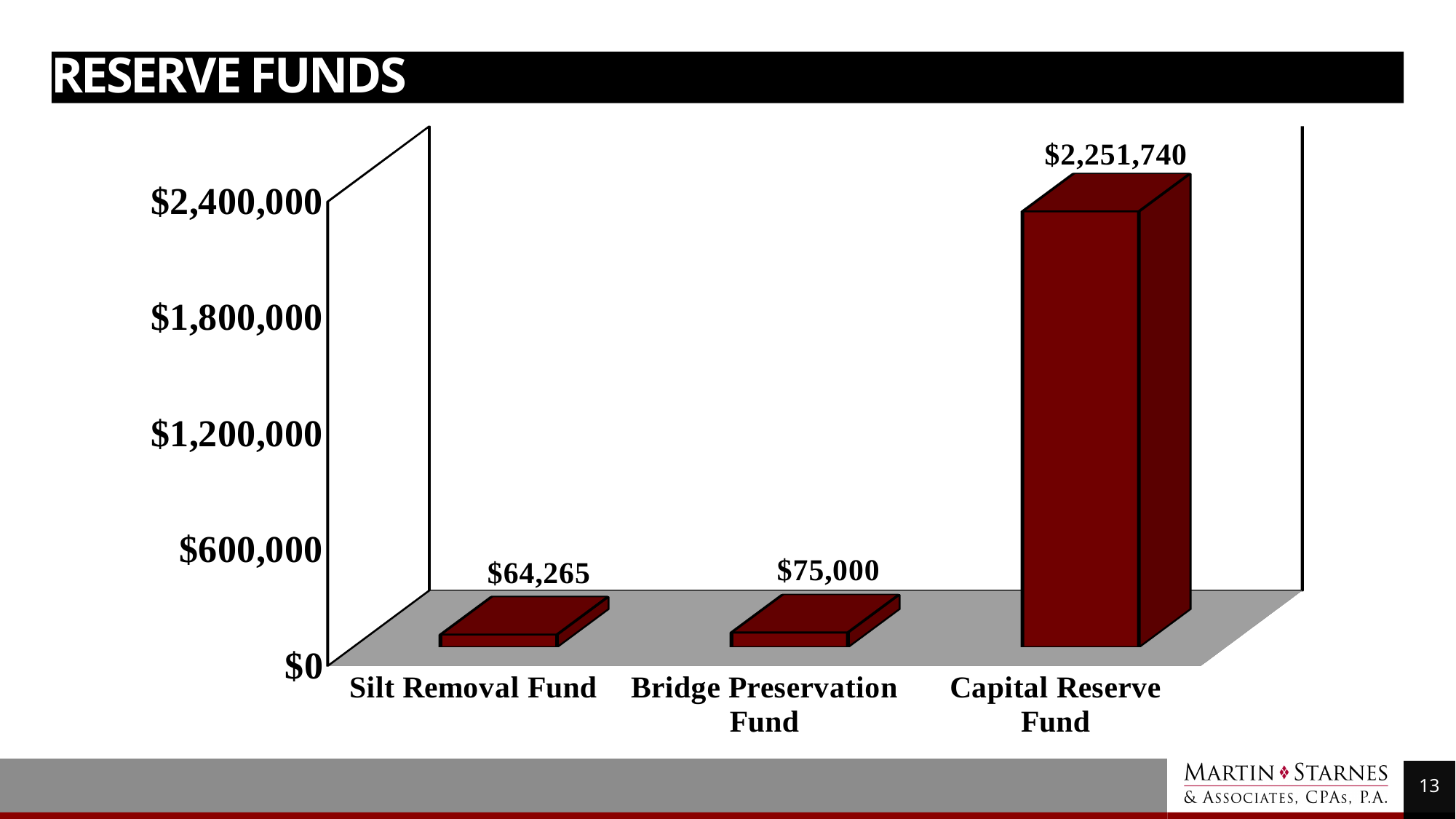
Is the value for the Capital Reserve Fund greater or less than $1,800,000? greater Which fund has the lowest value? Silt Removal Fund What is the value for the Bridge Preservation Fund? $75,000 What is the difference between the Capital Reserve Fund and the Bridge Preservation Fund? $2,176,740 How many funds are shown in the chart? 3 What is the title of the slide? RESERVE FUNDS Which is larger, the Silt Removal Fund or the Bridge Preservation Fund? Bridge Preservation Fund What kind of chart is shown on the slide? bar chart Which fund has the highest value? Capital Reserve Fund What is the value for the Capital Reserve Fund? $2,251,740 What is the value for the Silt Removal Fund? $64,265 What is the difference between the Bridge Preservation Fund and the Silt Removal Fund? $10,735